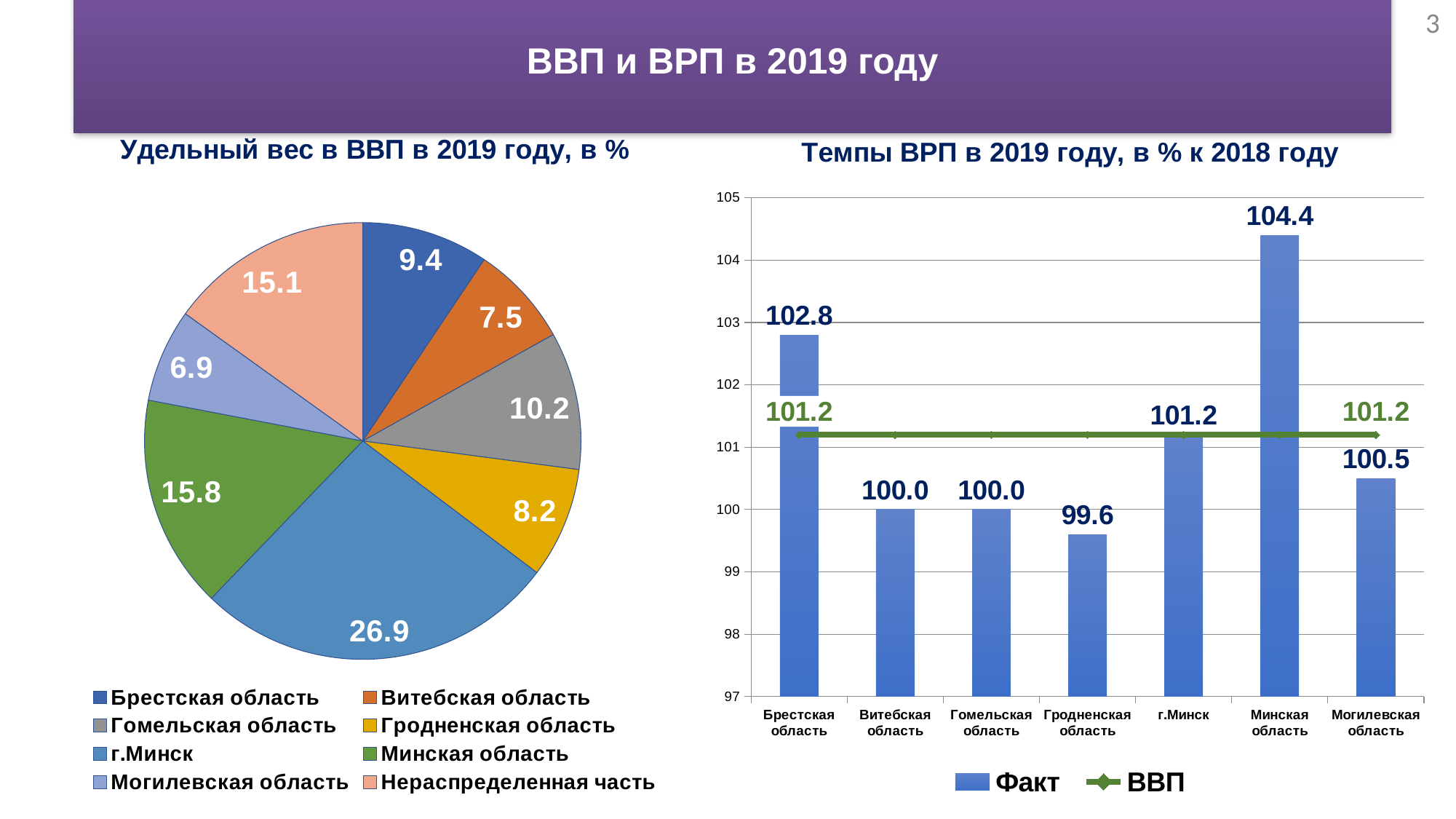
In the bar chart 'Темпы ВРП в 2019 году, в % к 2018 году', what is the Факт value for Минская область? 104.4 In the bar chart 'Темпы ВРП в 2019 году, в % к 2018 году', how many series does the legend list? 2 In the pie chart 'Удельный вес в ВВП в 2019 году, в %', what is the value for Могилевская область? 6.9 In the pie chart 'Удельный вес в ВВП в 2019 году, в %', which category has the largest slice? г.Минск In the pie chart 'Удельный вес в ВВП в 2019 году, в %', how many slices are there? 8 In the pie chart 'Удельный вес в ВВП в 2019 году, в %', what is the difference between Минская область and Нераспределенная часть? 0.7 In the bar chart 'Темпы ВРП в 2019 году, в % к 2018 году', which is larger: the Факт value for Брестская область or for г.Минск? Брестская область In the bar chart 'Темпы ВРП в 2019 году, в % к 2018 году', what is the difference between the Факт values for Брестская область and Могилевская область? 2.3 In the pie chart 'Удельный вес в ВВП в 2019 году, в %', what is the value for г.Минск? 26.9 In the bar chart 'Темпы ВРП в 2019 году, в % к 2018 году', which region has the lowest Факт value? Гродненская область What type of chart is the one on the right, 'Темпы ВРП в 2019 году, в % к 2018 году'? Bar chart with a line In the pie chart 'Удельный вес в ВВП в 2019 году, в %', which category has the smallest slice? Могилевская область